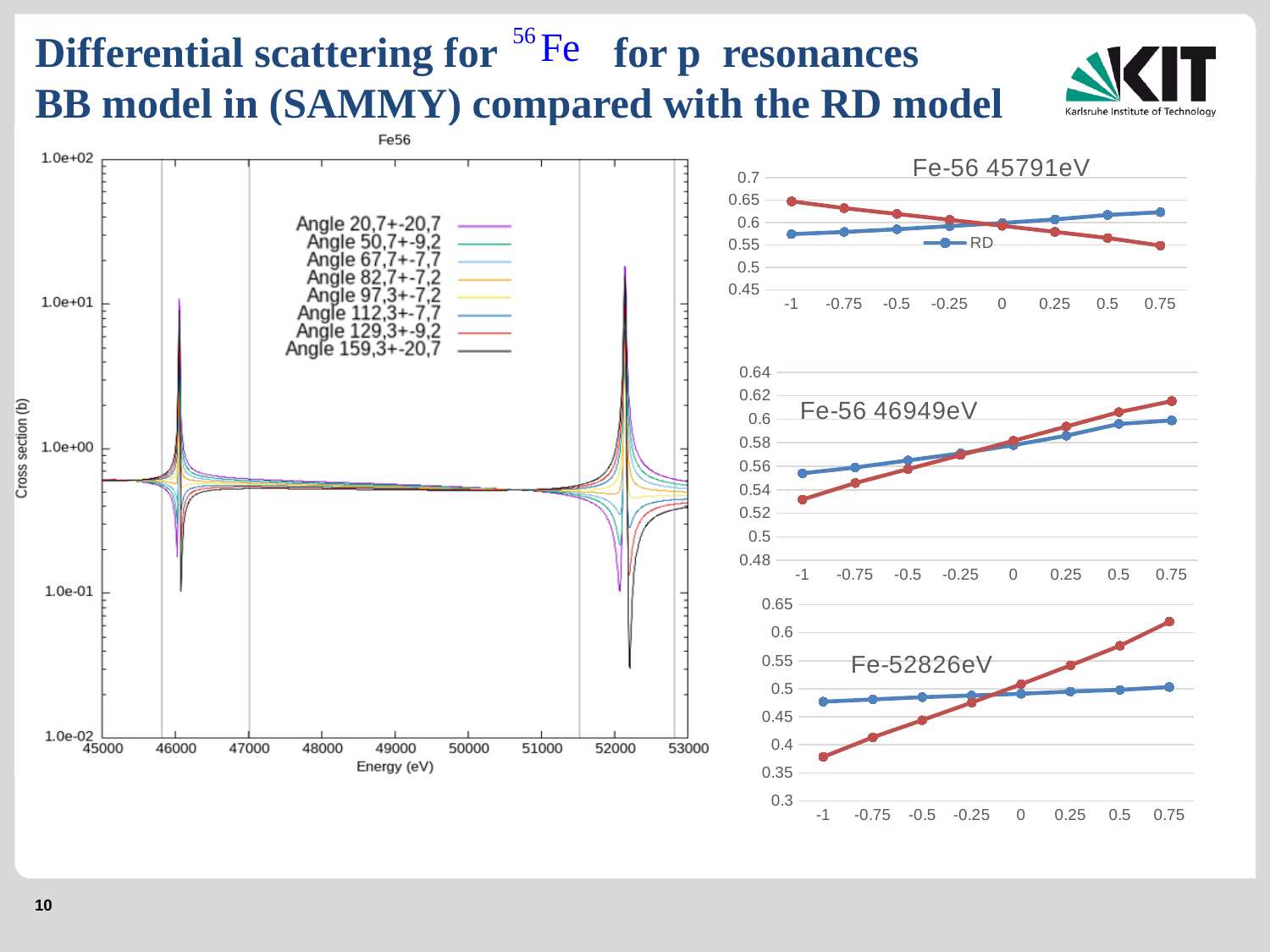
In the chart titled Fe-56 45791eV, does the blue series rise or fall as x increases from -1 to 0.75? rise In the chart titled Fe-56 45791eV, does the red series rise or fall as x increases from -1 to 0.75? fall In the chart titled Fe-56 45791eV, at x = -1, which series has the larger value, the red or the blue? red In the large chart titled Fe56 on the left, how many series does the legend list? 8 In the large chart titled Fe56 on the left, what is the label of the y axis? Cross section (b) In the chart titled Fe-52826eV, at x = 0.75, which series has the larger value, the red or the blue? red In the chart titled Fe-56 46949eV, is the value of the red series at x = -1 greater or less than 0.54? less In the large chart titled Fe56 on the left, what is the label of the x axis? Energy (eV) In the chart titled Fe-56 45791eV, is the value of the red series at x = -1 greater or less than 0.6? greater What kind of chart is the one titled Fe-56 46949eV? line chart In the chart titled Fe-52826eV, is the value of the blue series at x = -1 greater or less than 0.5? less In the chart titled Fe-56 46949eV, how many data points does each series have? 8